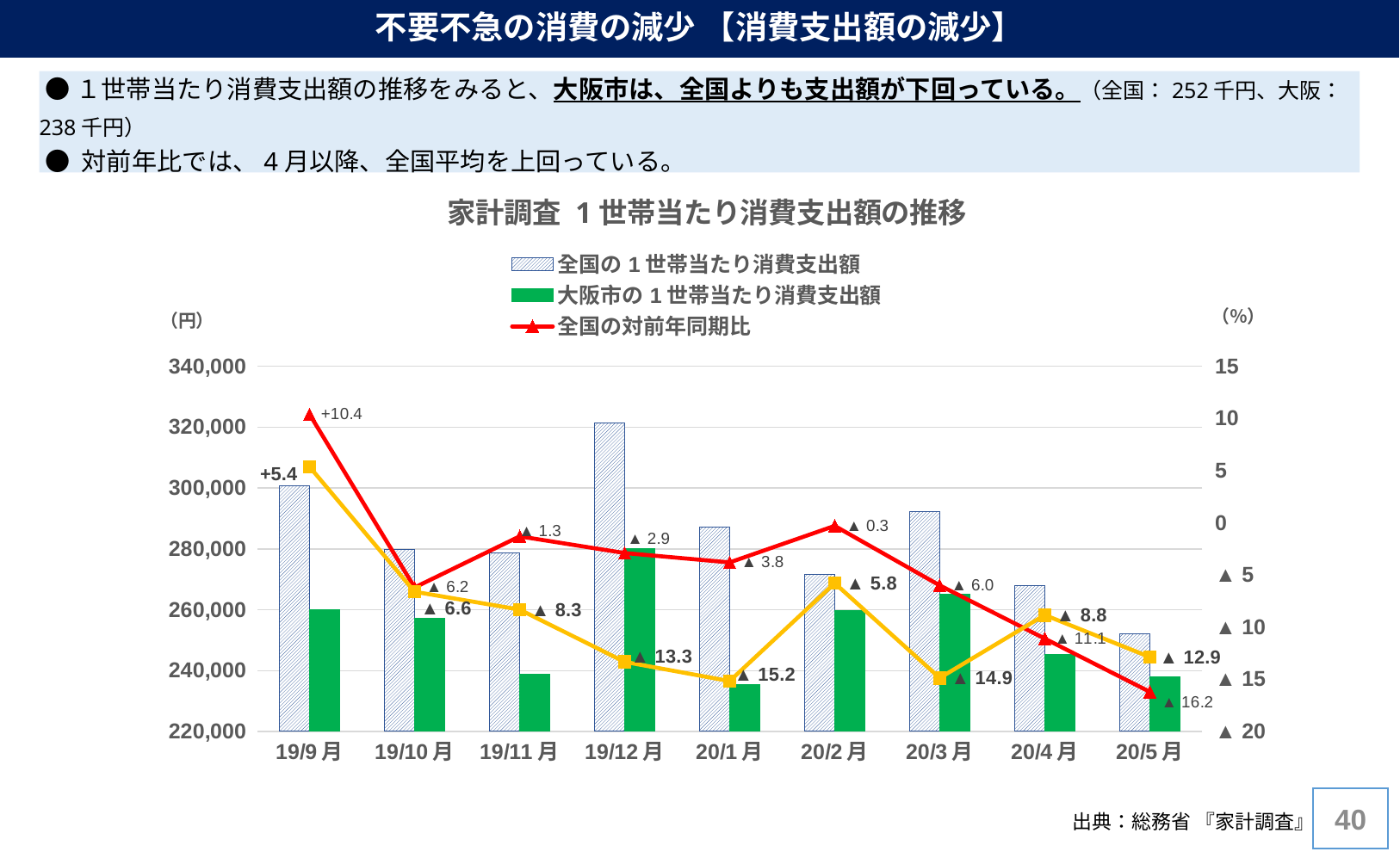
What is the value of 全国の対前年同期比 for 19/9月? +10.4 Does 全国の対前年同期比 rise or fall from 20/2月 to 20/5月? fall For 19/12月, which is larger: 全国の1世帯当たり消費支出額 or 大阪市の1世帯当たり消費支出額? 全国の1世帯当たり消費支出額 In which month is 全国の対前年同期比 highest? 19/9月 Is the value of 大阪市の1世帯当たり消費支出額 for 20/3月 greater or less than 260,000? greater Is the value of 大阪市の1世帯当たり消費支出額 for 20/1月 greater or less than 240,000? less What is the value of 全国の対前年同期比 for 20/5月? ▲16.2 How many months are shown on the x axis of the chart? 9 What kind of chart is shown on the slide? A combination bar and line chart In which month is 全国の対前年同期比 lowest? 20/5月 What is the value of 全国の対前年同期比 for 20/2月? ▲0.3 How many series does the chart legend list? 3